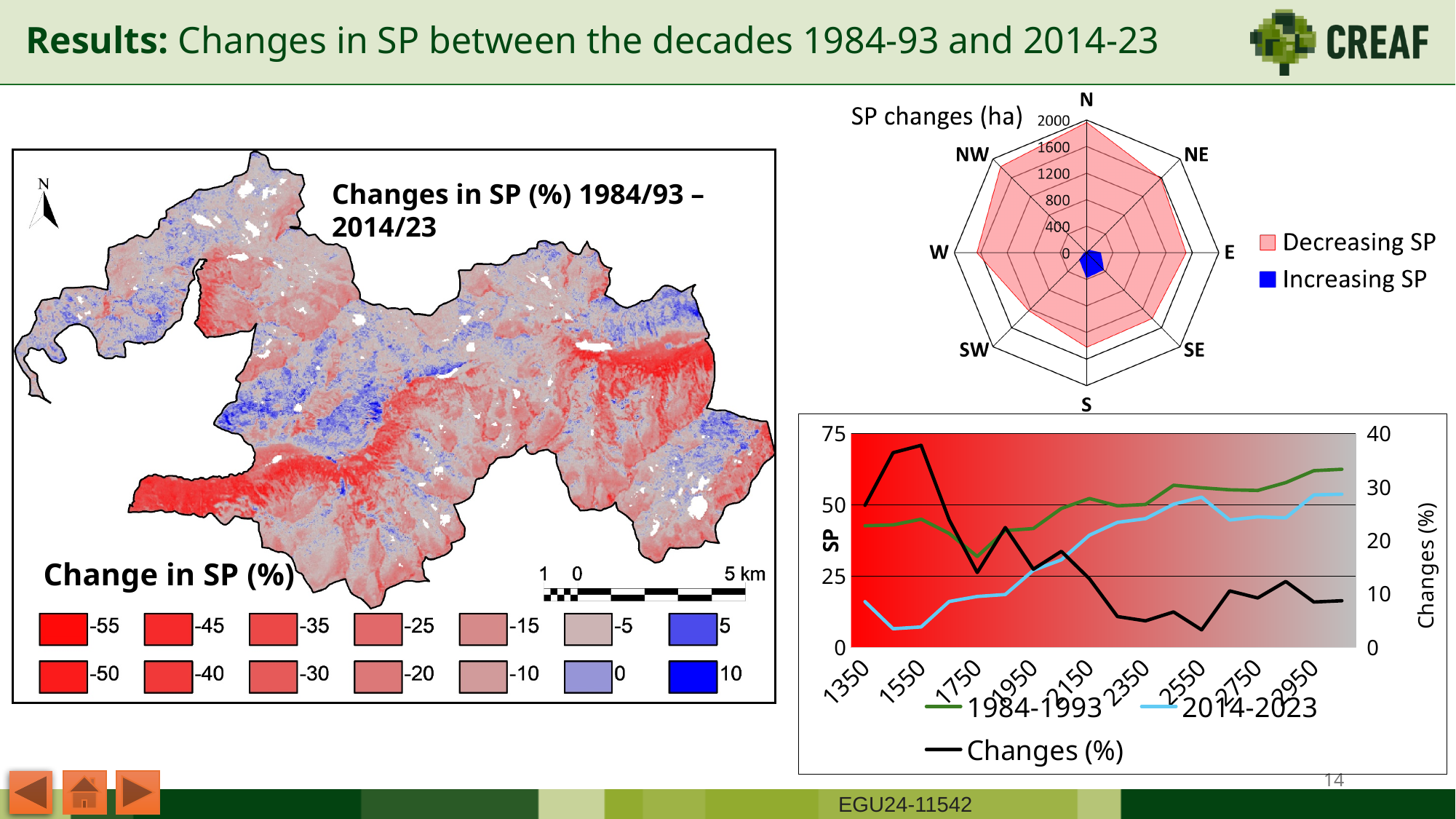
On the 'SP changes (ha)' radar chart, is the Decreasing SP value for N greater or less than 1600? greater In the line chart at the bottom right, does the 1984-1993 series generally rise or fall from 1350 to 2950 along the x axis? rise What is the maximum value shown on the radial axis of the 'SP changes (ha)' radar chart? 2000 On the 'SP changes (ha)' radar chart, which series has the larger value in the N direction, Decreasing SP or Increasing SP? Decreasing SP What is the label of the right-hand vertical axis of the line chart at the bottom right? Changes (%) How many series does the legend of the 'SP changes (ha)' radar chart list? 2 How many series does the legend of the line chart at the bottom right of the slide list? 3 What kind of chart is the 'SP changes (ha)' chart at the top right of the slide? radar chart In the line chart at the bottom right, is the Changes (%) value at 2550 greater or less than 10 on the right-hand axis? less How many direction categories are plotted on the 'SP changes (ha)' radar chart? 8 In the line chart at the bottom right, which series has the higher value at 1350, 1984-1993 or 2014-2023? 1984-1993 On the 'SP changes (ha)' radar chart, is the Increasing SP value for N greater or less than 400? less